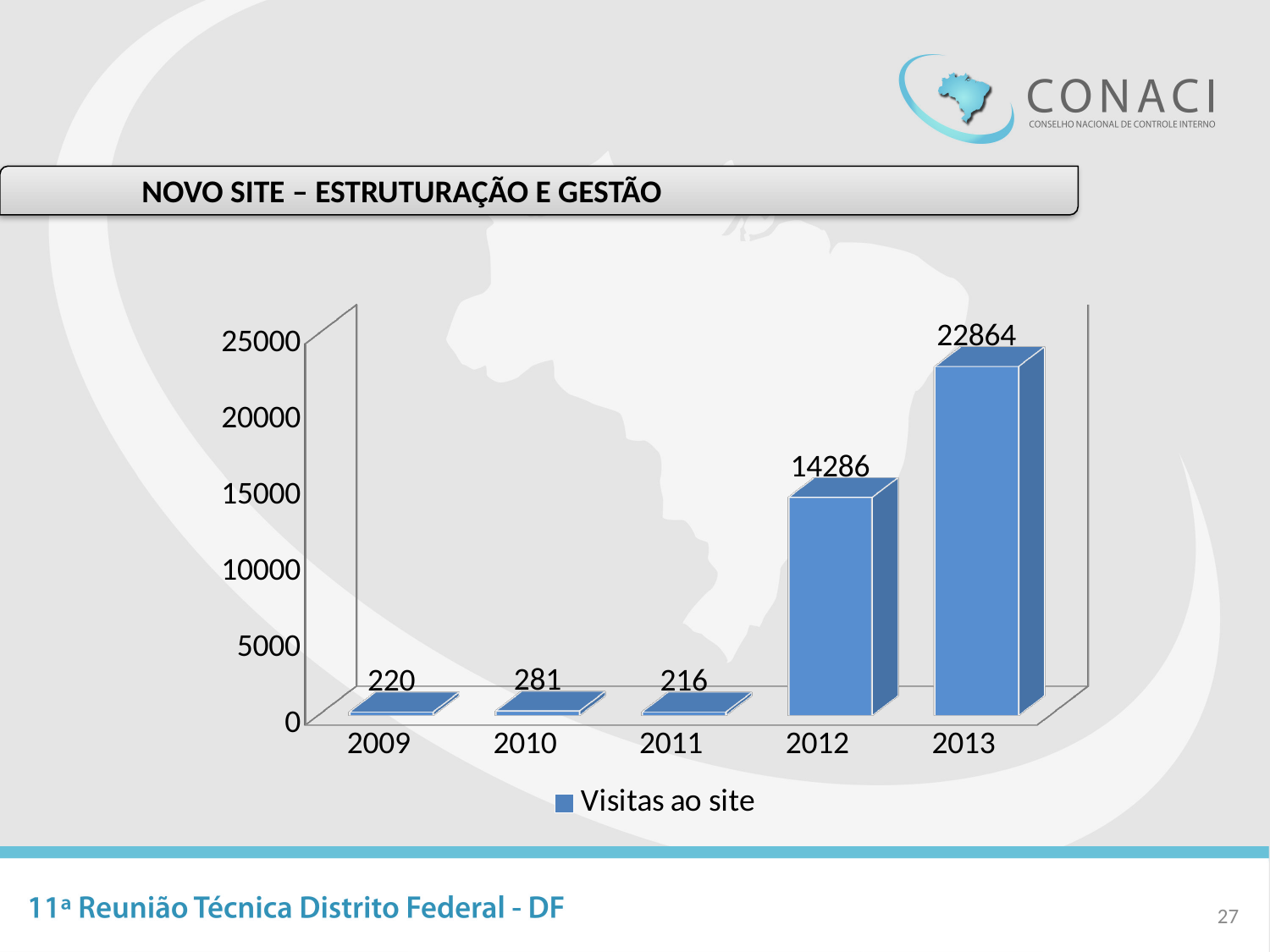
Which year has the highest number of site visits? 2013 Is the value for 2012 greater or less than 10000? greater What kind of chart is shown on the slide? bar chart What is the value for 2013? 22864 What is the value for 2012? 14286 What is the difference between the values for 2010 and 2009? 61 What is the difference between the values for 2013 and 2012? 8578 How many years are shown on the x axis? 5 What is the legend entry for the series shown? Visitas ao site Which year has the lowest number of site visits? 2011 What is the value for 2009? 220 Which is larger, the value for 2010 or the value for 2011? 2010